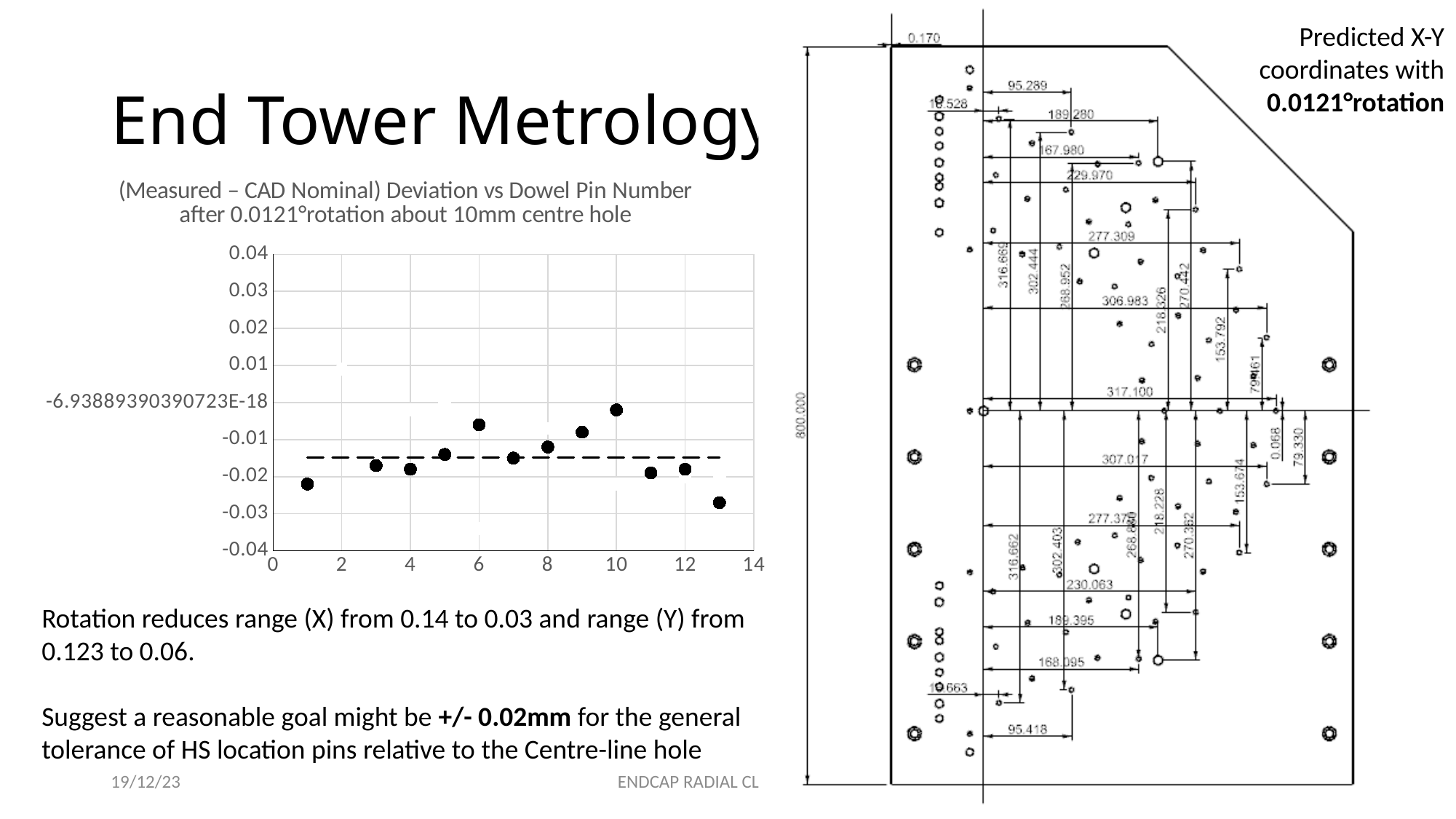
In the deviation chart, which has the larger deviation value: dowel pin 10 or dowel pin 1? dowel pin 10 What kind of chart is shown on the left of the slide? scatter chart In the deviation chart, which has the larger deviation value: dowel pin 6 or dowel pin 13? dowel pin 6 In the deviation chart, is the value for dowel pin 10 greater or less than -0.01? greater What is the title of the chart on the left of the slide? (Measured – CAD Nominal) Deviation vs Dowel Pin Number after 0.0121°rotation about 10mm centre hole In the deviation chart, is the value for dowel pin 6 greater or less than -0.01? greater What is the maximum value shown on the y axis of the deviation chart? 0.04 In the deviation chart, which dowel pin number has the highest plotted deviation? 10 In the deviation chart, is the value for dowel pin 9 greater or less than -0.02? greater In the deviation chart, which dowel pin number has the lowest plotted deviation? 13